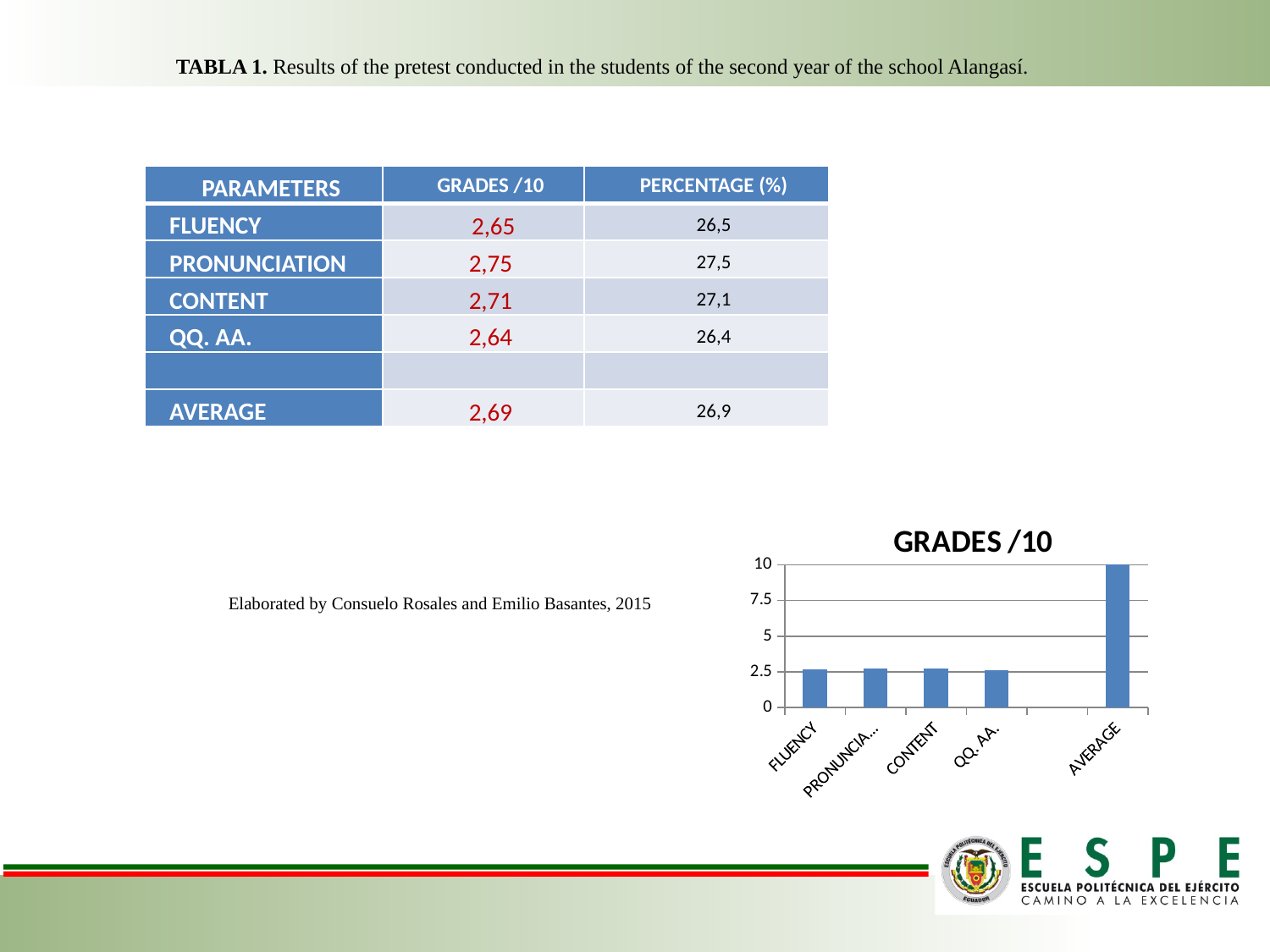
Is the value for FLUENCY in the chart greater or less than 5? less Which is larger in the chart, the bar for AVERAGE or the bar for FLUENCY? AVERAGE What is the highest value shown on the vertical axis of the chart? 10 Is the value for QQ. AA. in the chart greater or less than 5? less Which category has the highest bar in the chart? AVERAGE What is the title of the chart? GRADES /10 Is the value for AVERAGE in the chart greater or less than 7.5? greater What value does the AVERAGE bar reach in the chart? 10 What type of chart is shown on the slide? bar chart How many bars are plotted in the chart? 5